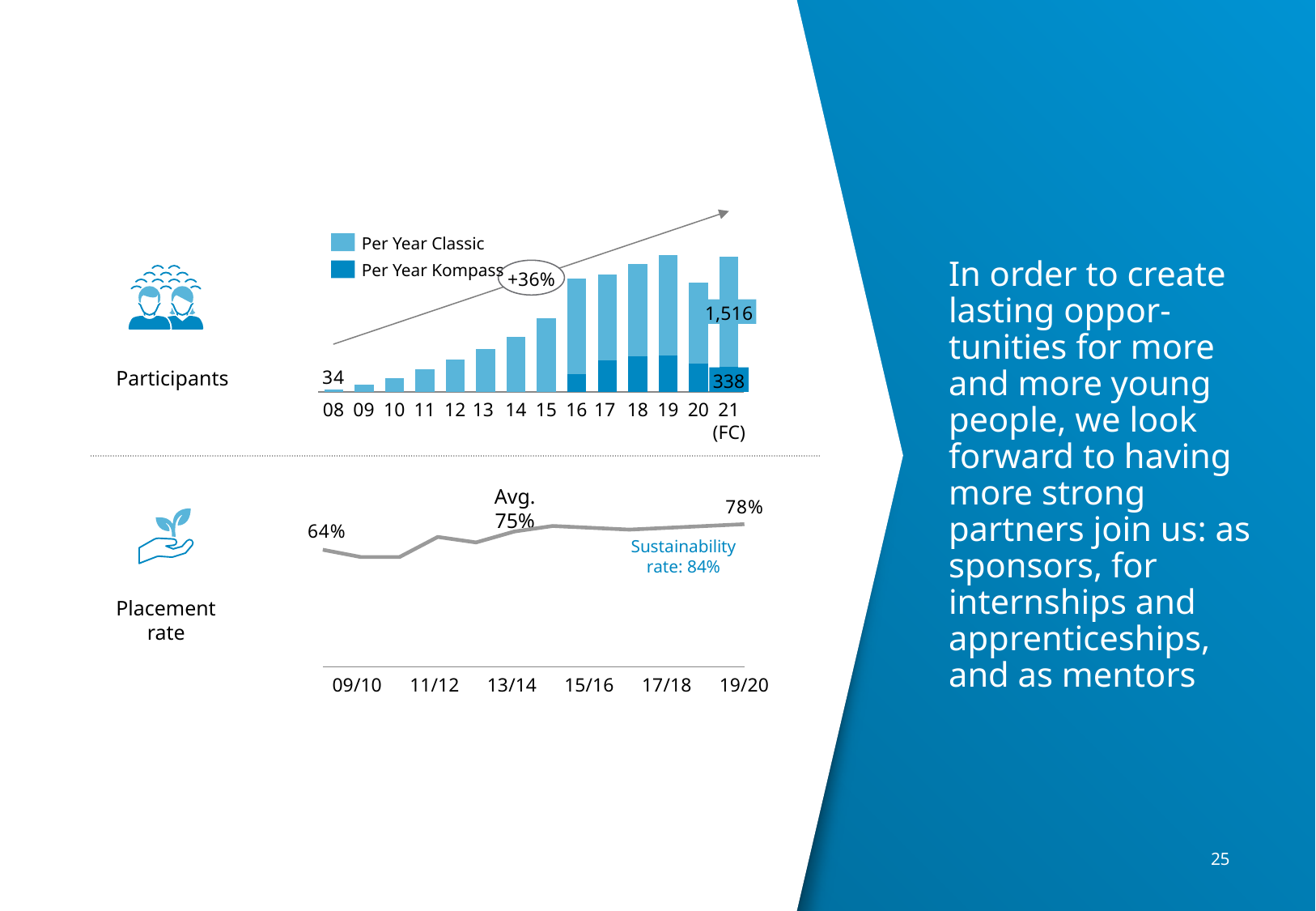
In the Participants chart, what is the value for 08? 34 In the Participants chart, what is the Per Year Classic value for 21 (FC)? 1,516 In the Placement rate chart, what is the average placement rate shown? 75% How many years are shown on the x axis of the Participants chart? 14 In the Participants chart, which year has the lowest number of participants? 08 In the Participants chart, which year has the taller bar, 15 or 16? 16 In the Participants chart, what is the Per Year Kompass value for 21 (FC)? 338 In the Placement rate chart, what is the placement rate for 19/20? 78% In the Placement rate chart, what is the placement rate for 09/10? 64% How many series does the legend of the Participants chart list? 2 What kind of chart is the Participants chart? bar chart What kind of chart is the Placement rate chart? line chart